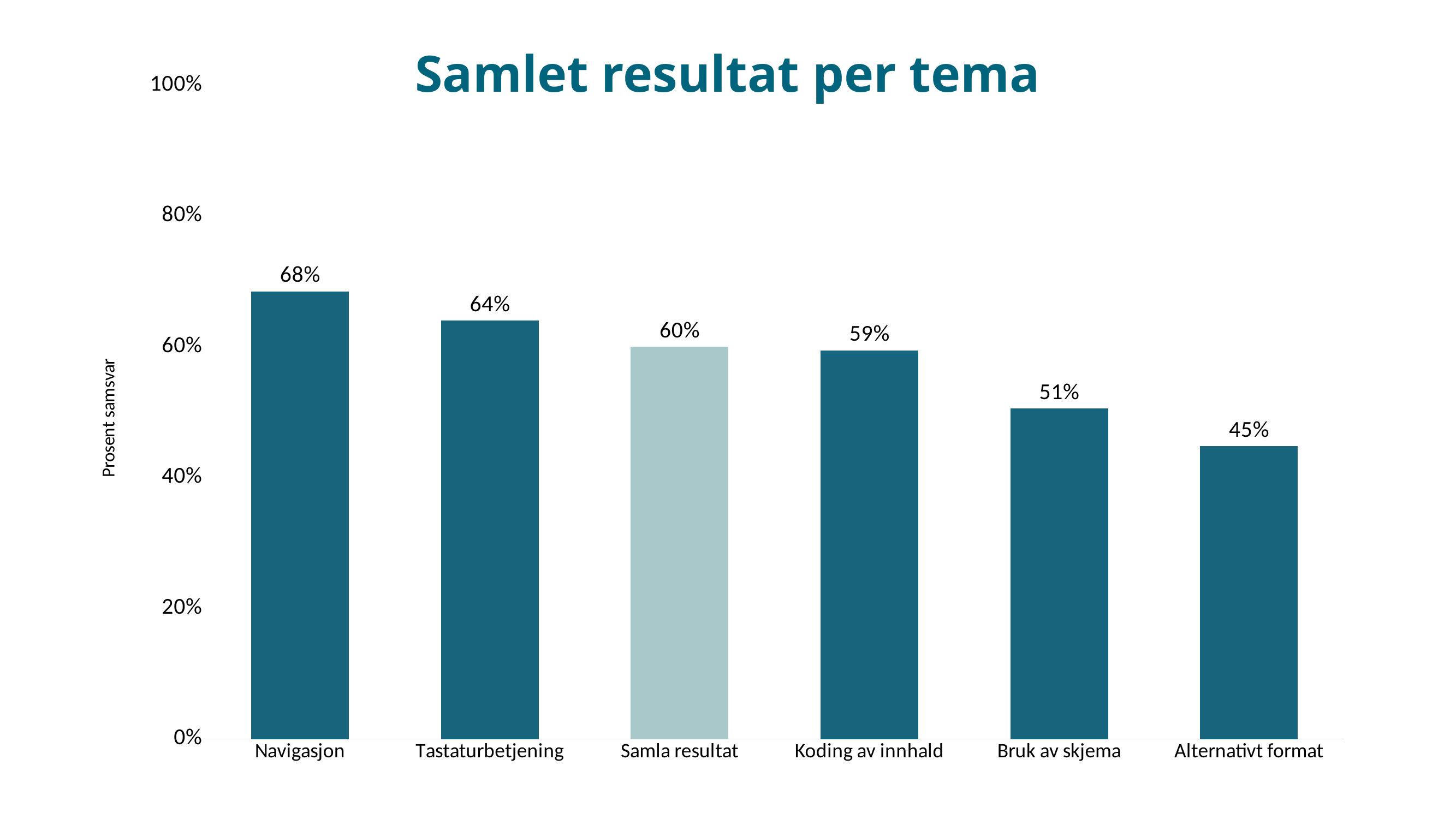
Which category has the lowest value? Alternativt format What is the value for Samla resultat? 60% What is the value for Bruk av skjema? 51% What is the value for Navigasjon? 68% What is the title of the chart? Samlet resultat per tema Which is larger, the value for Tastaturbetjening or the value for Bruk av skjema? Tastaturbetjening What kind of chart is shown on the slide? bar chart What is the difference between the values for Tastaturbetjening and Koding av innhald? 5% Which category has the highest value? Navigasjon Is the value for Koding av innhald greater or less than 40%? greater What is the difference between the values for Navigasjon and Alternativt format? 23% How many categories are shown on the x axis? 6